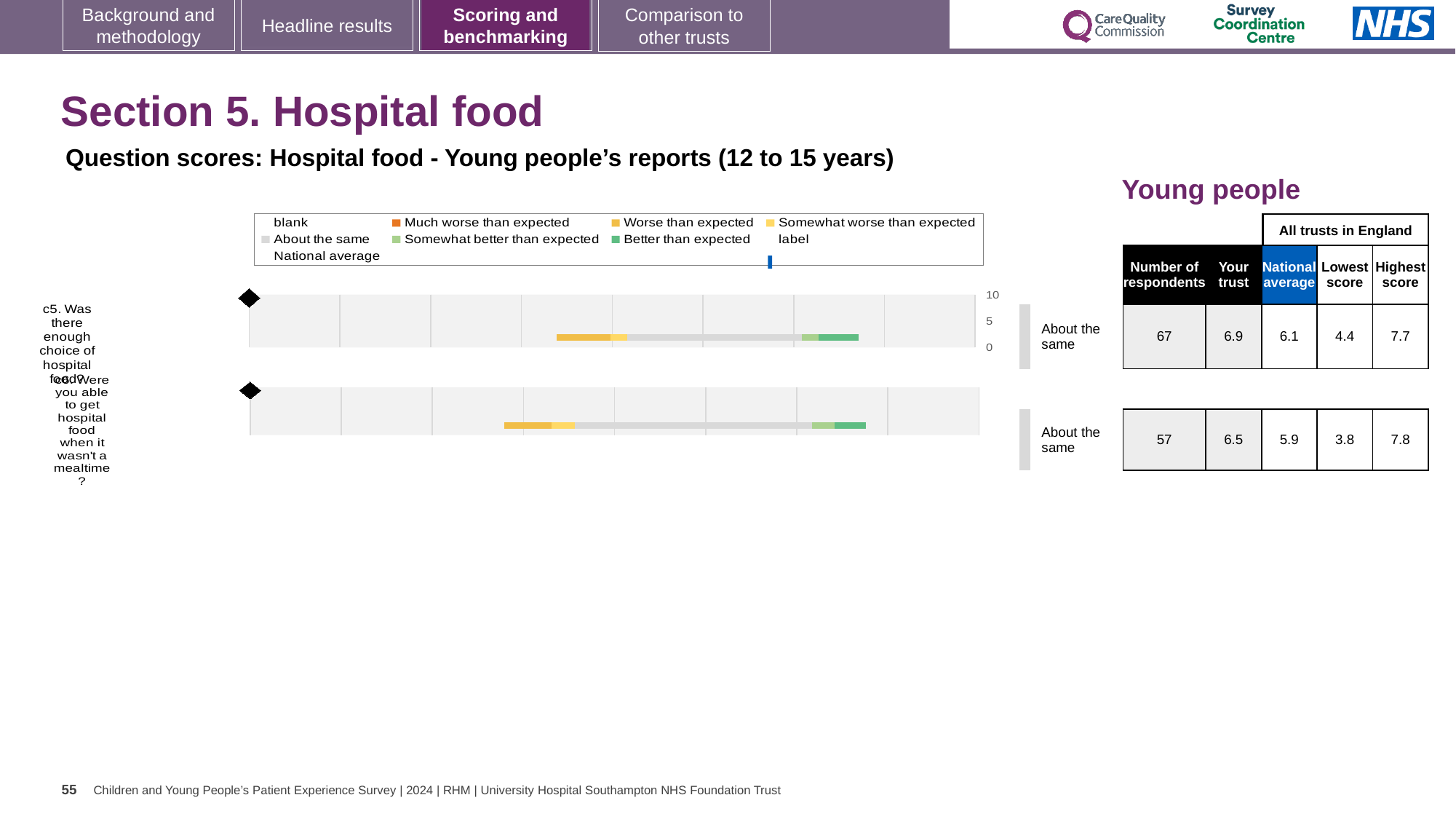
What is the national average score for question c5? 6.1 How many respondents answered question c5? 67 What is the 'Your trust' score for question c5 (Was there enough choice of hospital food?)? 6.9 Which is larger for question c6: the 'Your trust' score or the national average? Your trust What benchmark rating is shown next to the chart for both questions c5 and c6? About the same What kind of chart is used to show the question scores for hospital food? bar chart How many questions are plotted in the hospital food chart? 2 What is the 'Your trust' score for question c6 (Were you able to get hospital food when it wasn't a mealtime?)? 6.5 What is the lowest score across all trusts in England for question c6? 3.8 What is the difference between the highest and lowest scores across all trusts for question c5? 3.3 Which question has the higher 'Your trust' score, c5 or c6? c5 What is the difference between the 'Your trust' score and the national average for question c5? 0.8